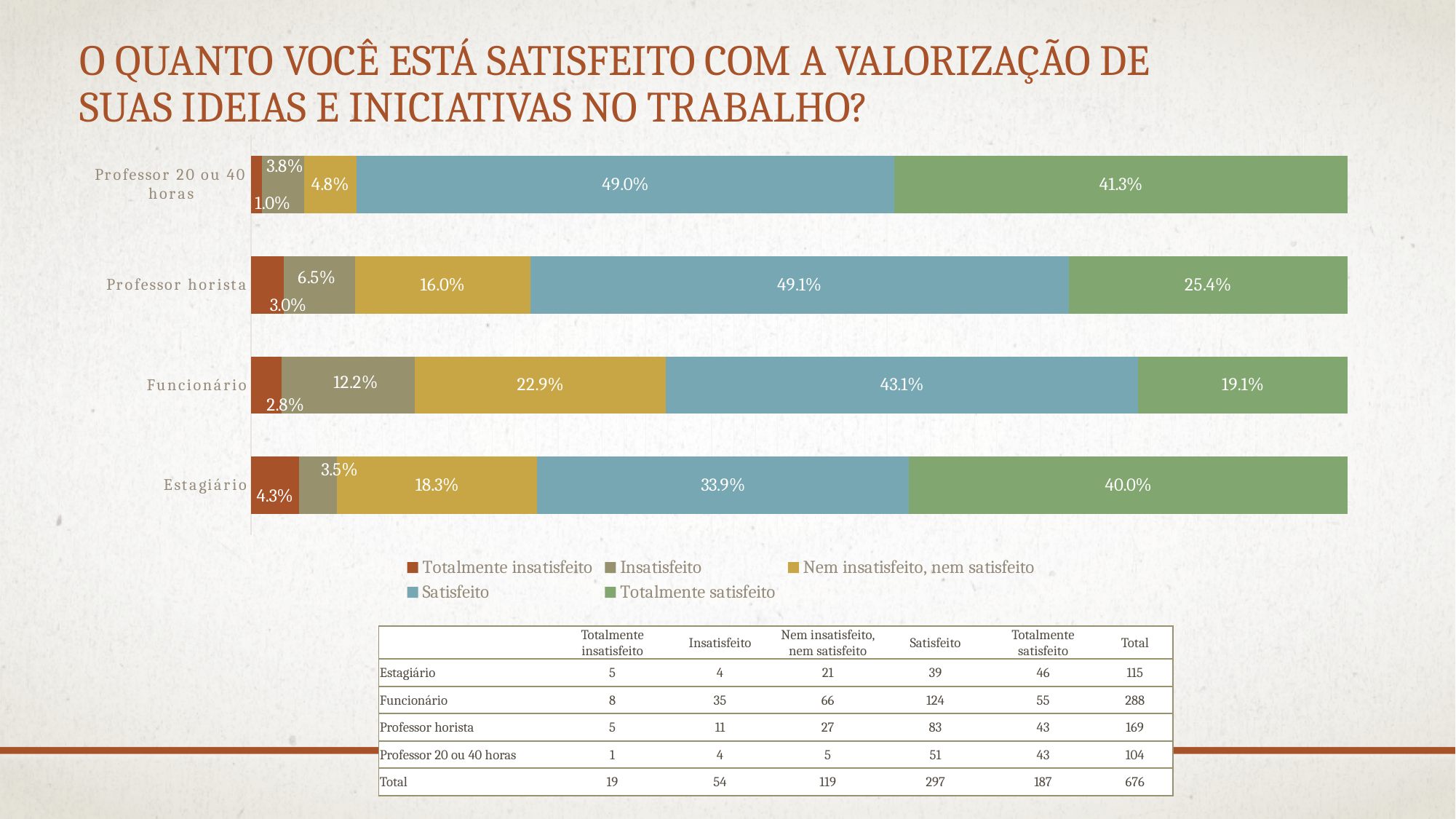
What kind of chart is shown on the slide? Stacked bar chart How many series does the chart legend list? 5 Which category has the highest "Totalmente satisfeito" percentage? Professor 20 ou 40 horas Which has a larger "Nem insatisfeito, nem satisfeito" share: Estagiário or Professor horista? Estagiário For Funcionário, what is the difference between the "Satisfeito" and "Totalmente satisfeito" percentages? 24.0% How many categories are shown on the chart? 4 Which category has the highest "Insatisfeito" percentage? Funcionário Which category has the lowest "Satisfeito" percentage? Estagiário What is the "Nem insatisfeito, nem satisfeito" value for Estagiário? 18.3% What percentage of Funcionário respondents answered "Satisfeito"? 43.1% What is the "Totalmente satisfeito" value for Professor horista? 25.4% What is the "Totalmente insatisfeito" value for Professor 20 ou 40 horas? 1.0%